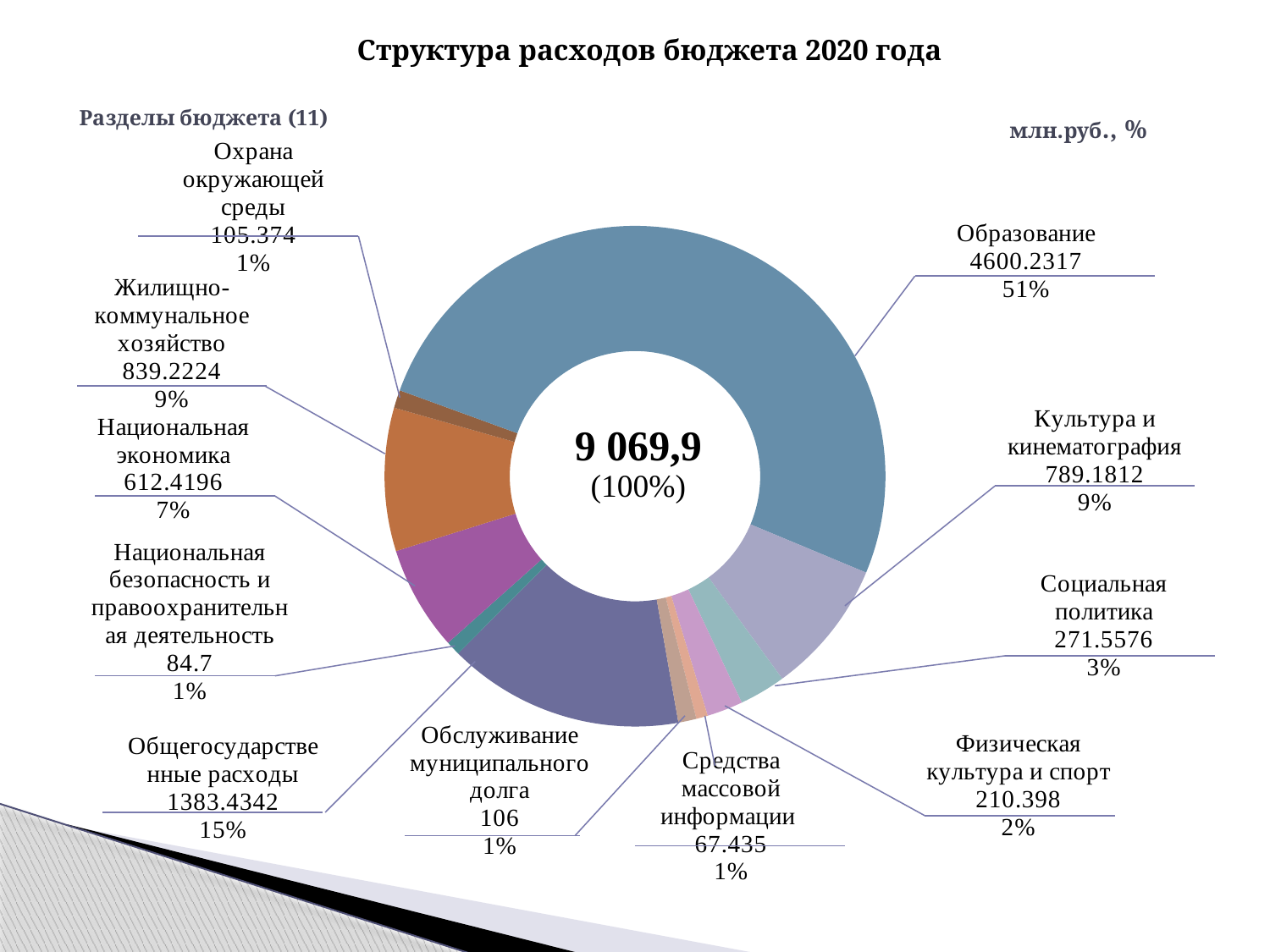
What total value is shown in the centre of the chart? 9 069,9 Which is larger: Жилищно-коммунальное хозяйство or Национальная экономика? Жилищно-коммунальное хозяйство What percentage share does Культура и кинематография have? 9% How many budget sections are shown in the chart? 11 Which budget section has the lowest expenditure? Средства массовой информации What percentage share does Образование have? 51% What type of chart is shown on the slide? Pie chart (doughnut) What is the value for Образование in млн.руб.? 4600.2317 What is the value for Общегосударственные расходы in млн.руб.? 1383.4342 What is the value for Жилищно-коммунальное хозяйство in млн.руб.? 839.2224 Which budget section has the highest expenditure? Образование What is the difference between Образование and Общегосударственные расходы in млн.руб.? 3216.7975